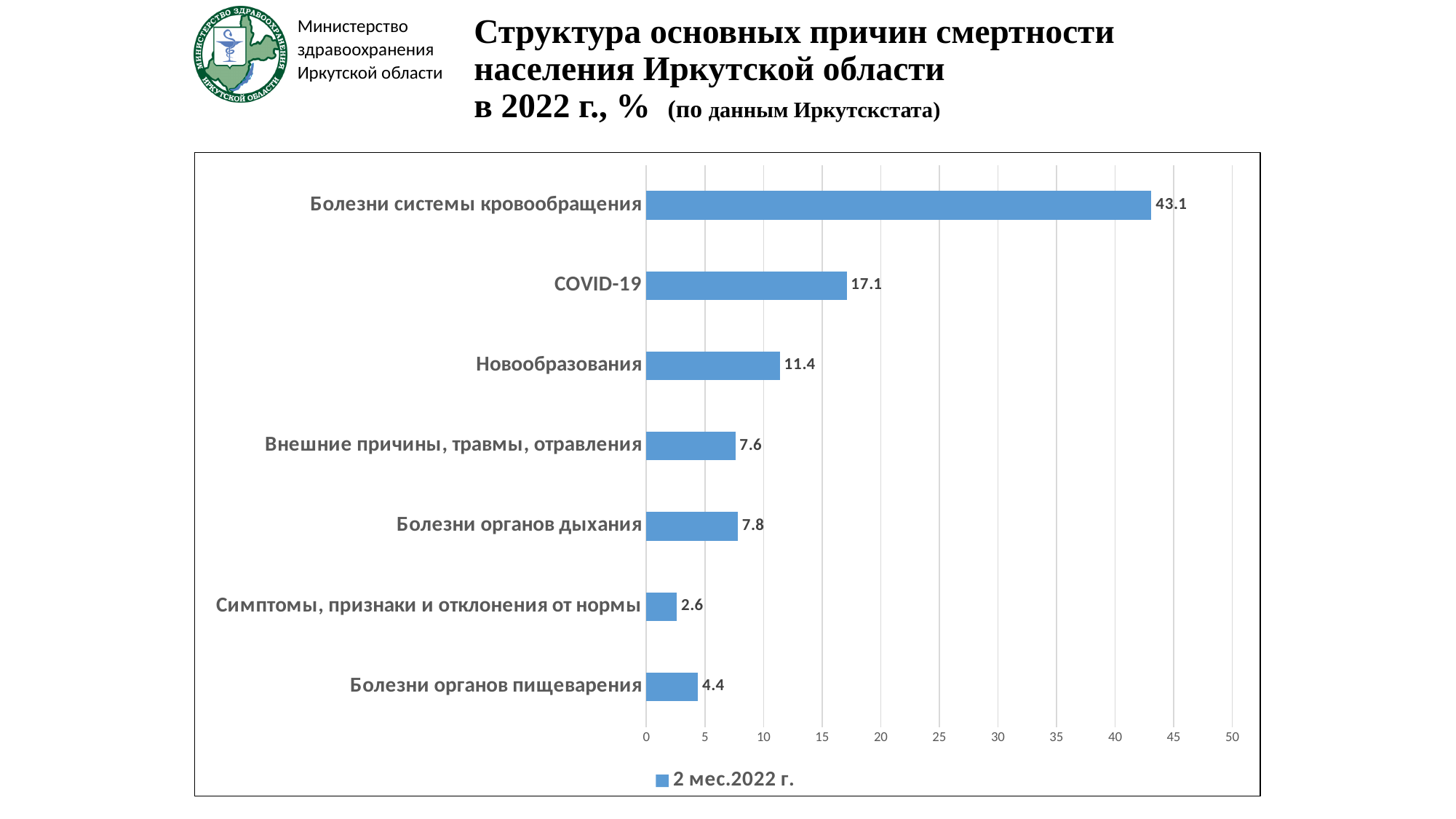
What is the value for Симптомы, признаки и отклонения от нормы? 2.6 How many categories are shown in the chart? 7 What is the value for COVID-19? 17.1 What is the value for Новообразования? 11.4 Which category has the highest value? Болезни системы кровообращения What kind of chart is shown on the slide? Bar chart What series name does the legend show? 2 мес.2022 г. Which is larger, the value for Новообразования or the value for Болезни органов пищеварения? Новообразования Which category has the lowest value? Симптомы, признаки и отклонения от нормы What is the difference between the values for Болезни системы кровообращения and COVID-19? 26 What is the difference between the values for Болезни органов дыхания and Внешние причины, травмы, отравления? 0.2 What is the value for Болезни системы кровообращения? 43.1